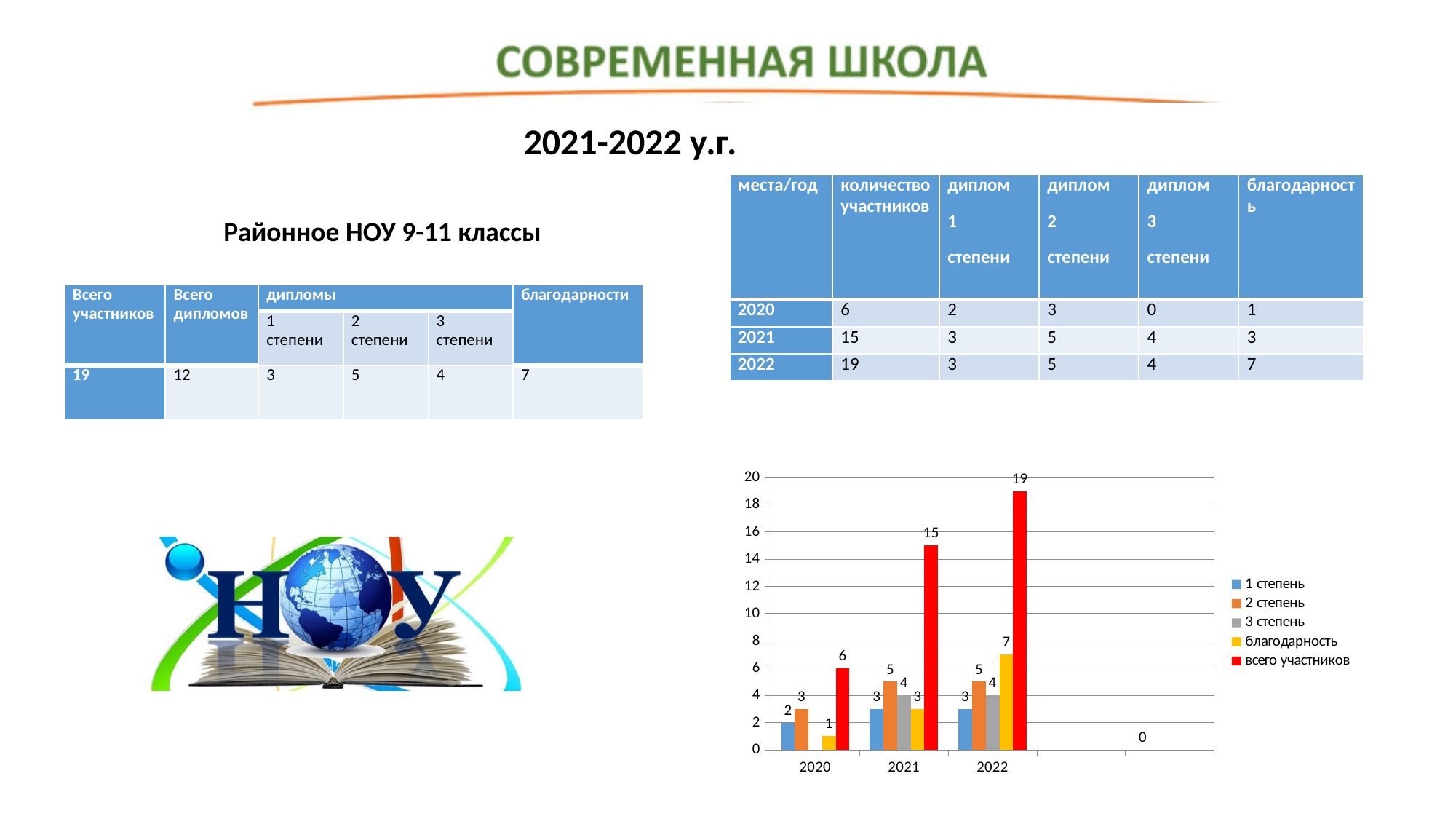
How many series does the chart legend list? 5 What is the difference between 'всего участников' in 2022 and in 2021? 4 What is the value for 'благодарность' in 2020? 1 What kind of chart is shown on the slide? bar chart What is the value for '3 степень' in 2022? 4 In which year is 'всего участников' highest? 2022 Which is larger: 'благодарность' in 2022 or 'благодарность' in 2021? 2022 Which colour represents 'всего участников' in the chart? red In which year is 'всего участников' lowest? 2020 What is the value for 'всего участников' in 2022? 19 Does 'всего участников' rise or fall from 2020 to 2022? rise What is the value for '2 степень' in 2021? 5